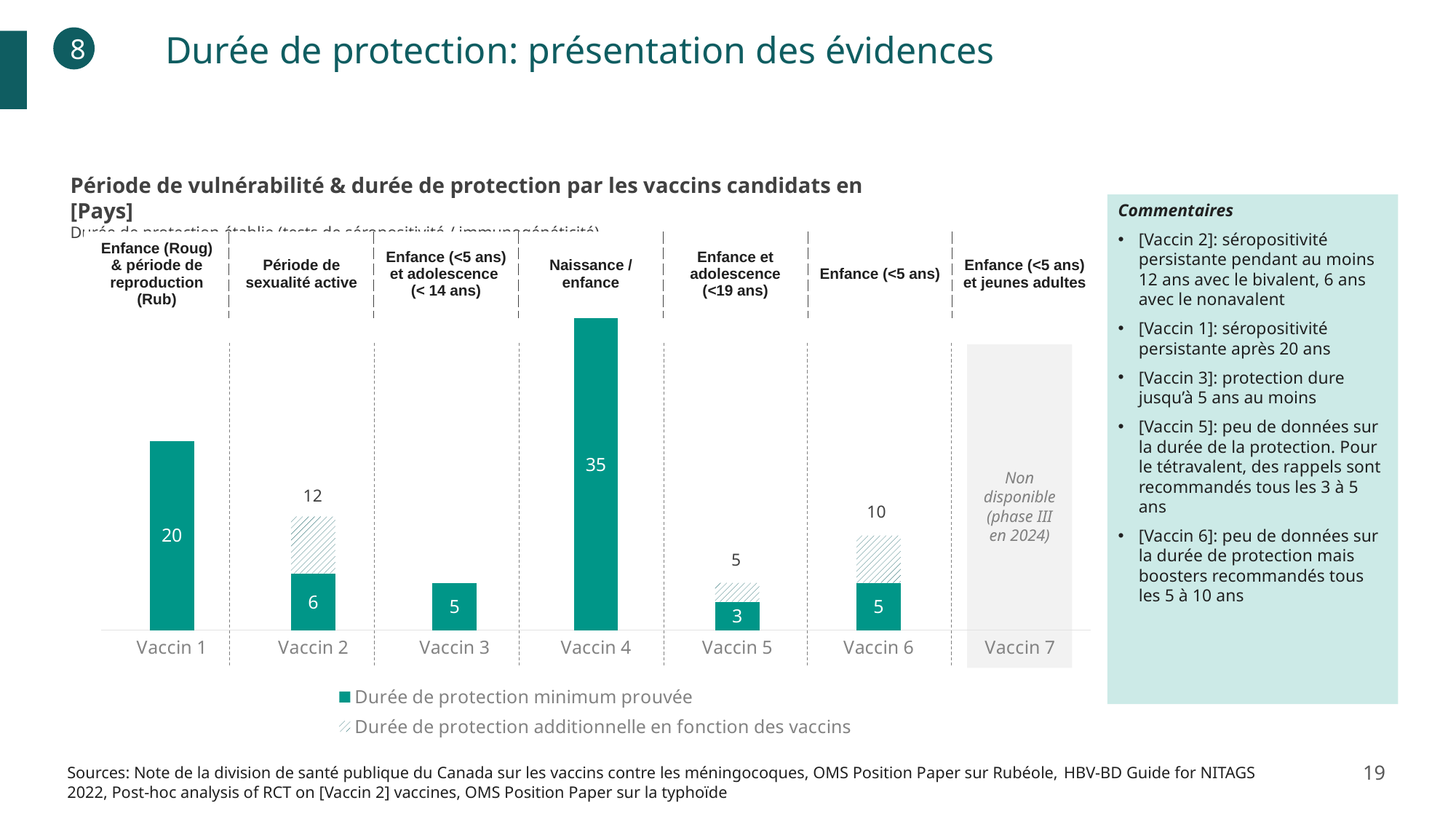
What total value is labelled above the stacked bar for Vaccin 2? 12 Which is larger: the minimum proven duration of protection for Vaccin 1 or for Vaccin 3? Vaccin 1 How many vaccine categories are shown on the x axis? 7 What is the minimum proven duration of protection for Vaccin 4? 35 What total value is labelled above the stacked bar for Vaccin 6? 10 What is the difference between the total labelled for Vaccin 2 (12) and its minimum proven duration (6)? 6 Which vaccine has the lowest minimum proven duration of protection among those with a plotted bar? Vaccin 5 Which vaccine has the highest minimum proven duration of protection? Vaccin 4 What is shown in place of a bar for Vaccin 7? Non disponible (phase III en 2024) What is the minimum proven duration of protection (Durée de protection minimum prouvée) for Vaccin 1? 20 How many series does the legend list? 2 What is the minimum proven duration of protection for Vaccin 5? 3